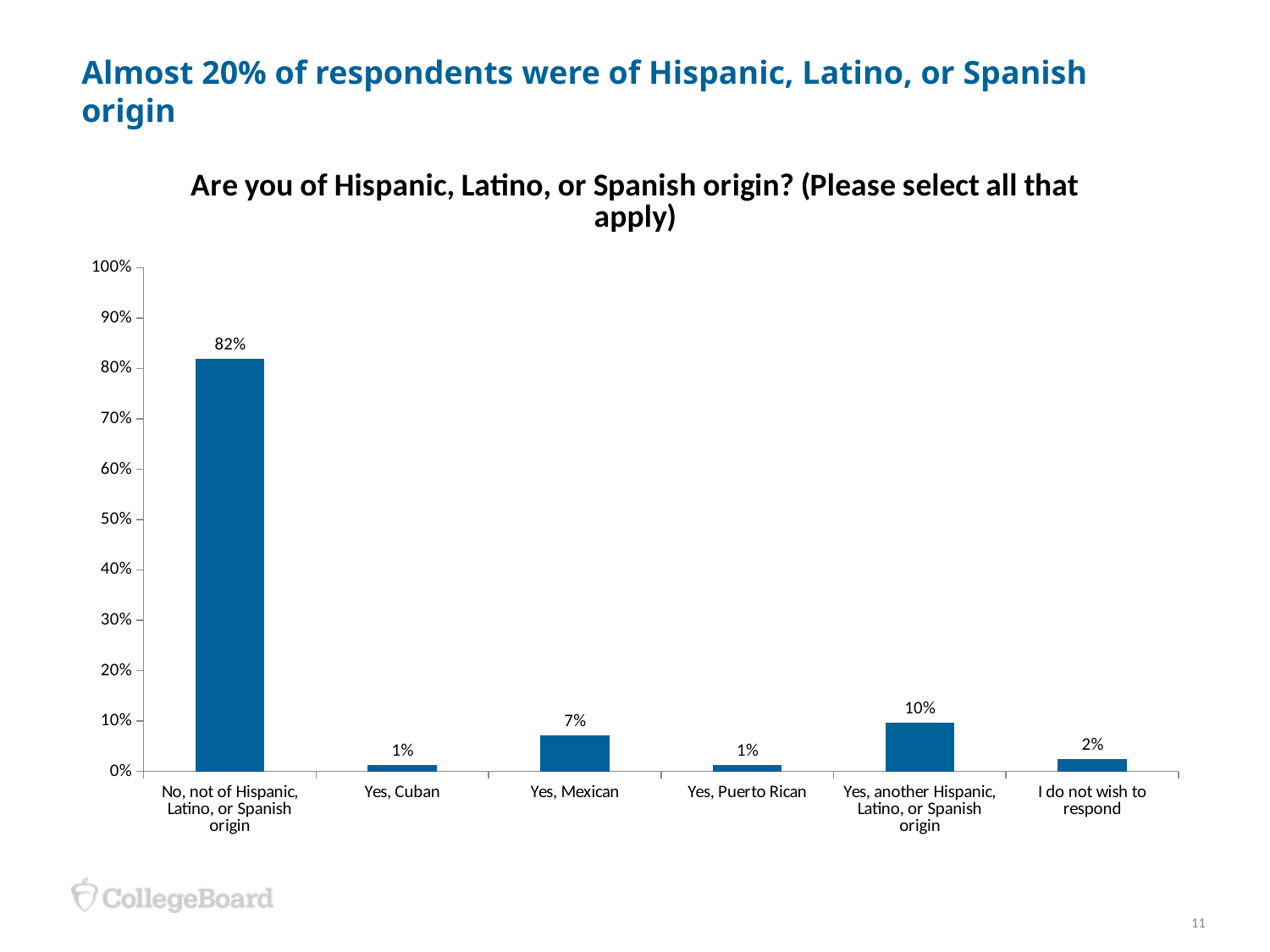
How many response categories are shown on the x axis? 6 Is the value for "No, not of Hispanic, Latino, or Spanish origin" greater or less than 50%? greater What is the difference in percentage points between "No, not of Hispanic, Latino, or Spanish origin" and "Yes, another Hispanic, Latino, or Spanish origin"? 72% What is the title of the chart? Are you of Hispanic, Latino, or Spanish origin? (Please select all that apply) What percentage of respondents answered "I do not wish to respond"? 2% What percentage of respondents answered "Yes, another Hispanic, Latino, or Spanish origin"? 10% What is the difference in percentage points between "Yes, another Hispanic, Latino, or Spanish origin" and "Yes, Mexican"? 3% What percentage of respondents answered "Yes, Mexican"? 7% Which response category has the highest percentage? No, not of Hispanic, Latino, or Spanish origin What percentage of respondents answered "No, not of Hispanic, Latino, or Spanish origin"? 82% Which is larger, the value for "Yes, Mexican" or the value for "I do not wish to respond"? Yes, Mexican What kind of chart is shown on the slide? Bar chart